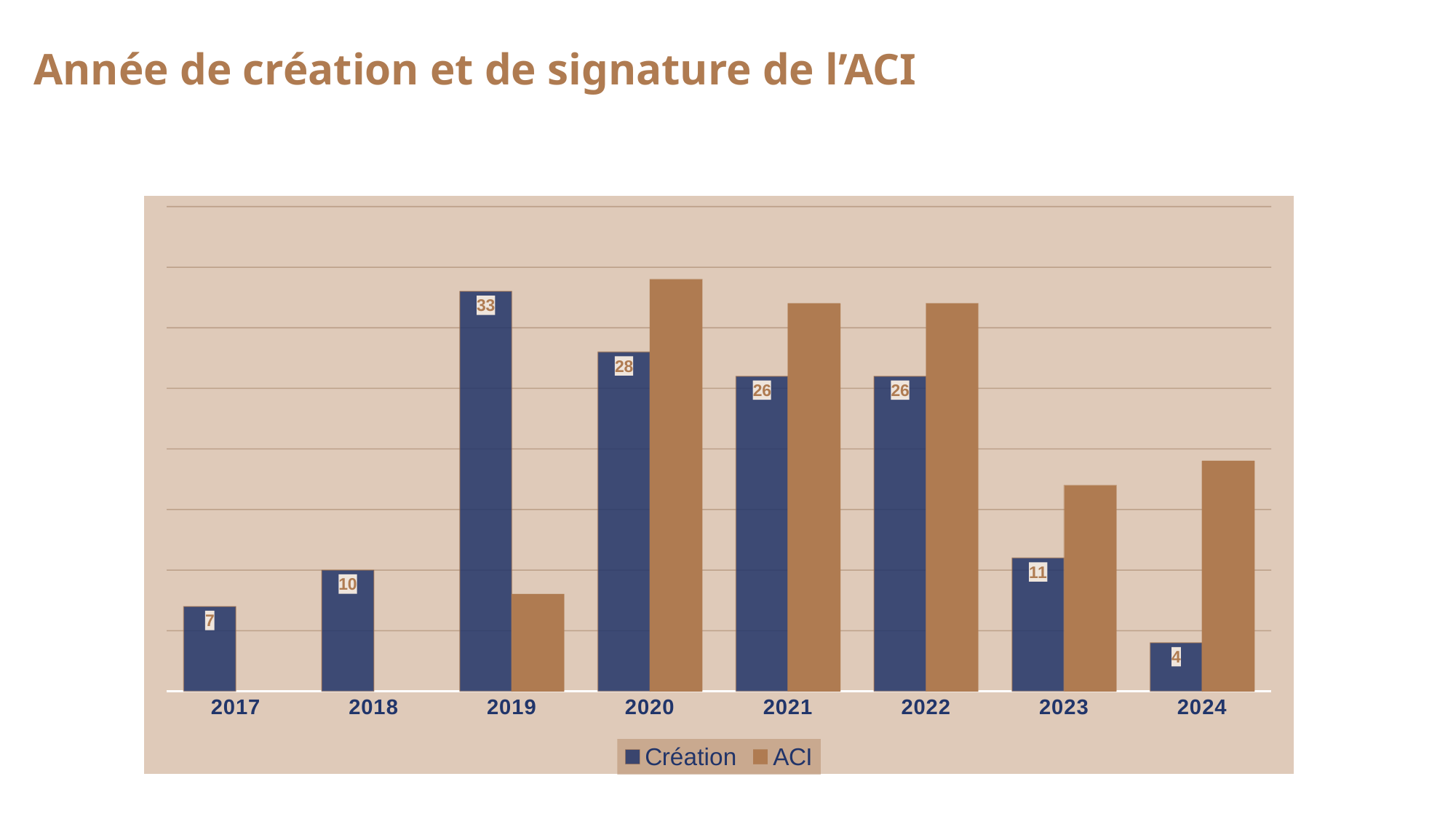
Which year has the highest ACI value? 2020 What is the Création value for 2017? 7 In 2019, which series has the larger value, Création or ACI? Création What is the difference between the Création values for 2018 and 2017? 3 How many years are shown on the x axis? 8 What is the Création value for 2019? 33 What is the Création value for 2024? 4 Which year has the highest Création value? 2019 How many series does the legend list? 2 What is the difference between the Création values for 2019 and 2020? 5 In 2020, which series has the larger value, Création or ACI? ACI Which year has the lowest Création value? 2024